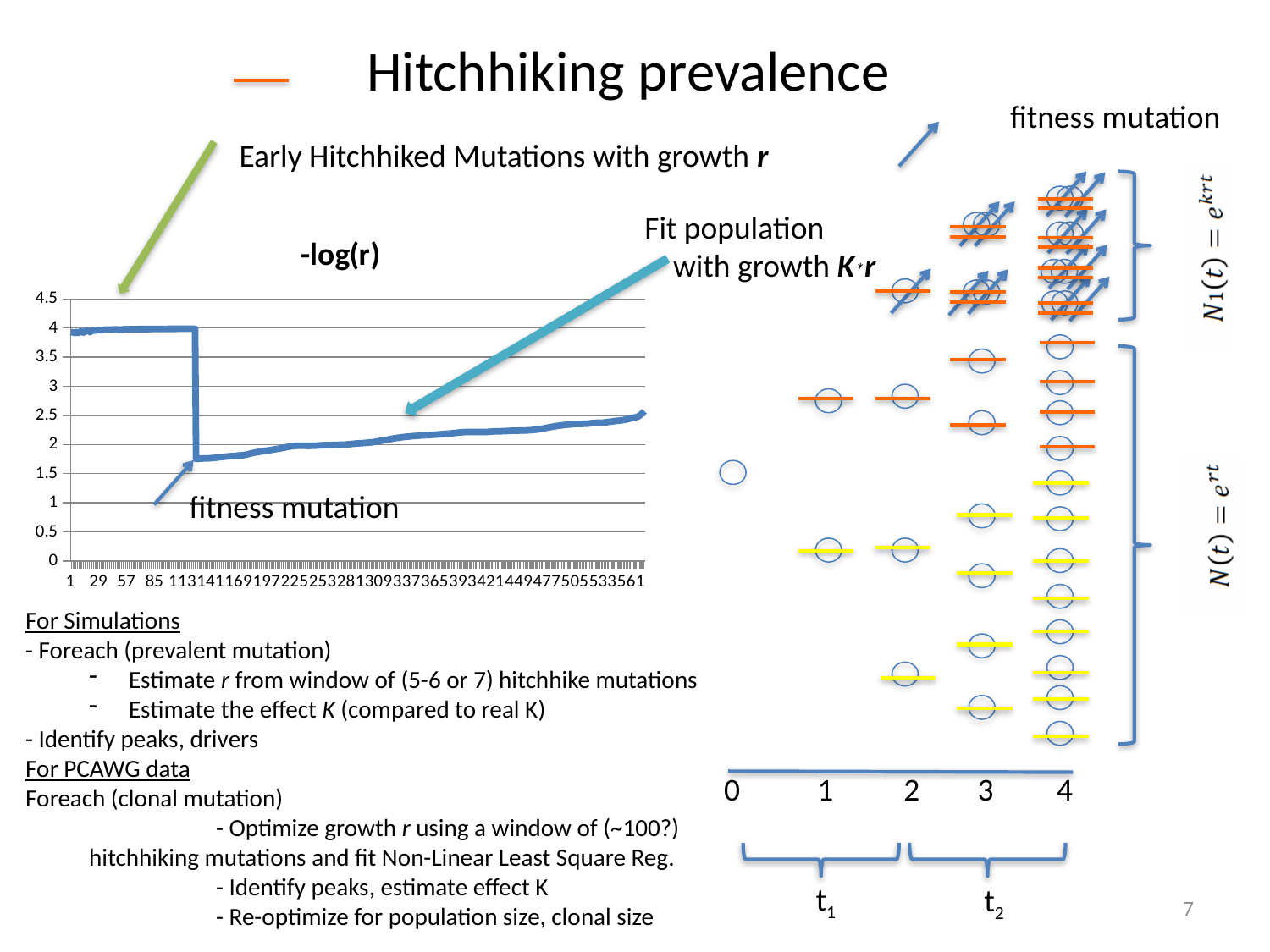
How many lines are plotted on the chart? 1 After the sharp drop, does the line rise or fall as x increases toward 561? rise What kind of chart is shown on the slide? line chart Is the value of the line at x = 281 greater or less than 2.5? less Is the value of the line at x = 1 greater or less than 3? greater Which is larger, the value of the line at x = 1 or at x = 561? x = 1 What is the title of the chart? -log(r) Is the value of the line at x = 561 greater or less than 3? less Comparing the start of the line to its end, does the value rise or fall overall? fall What is the highest tick value shown on the y axis? 4.5